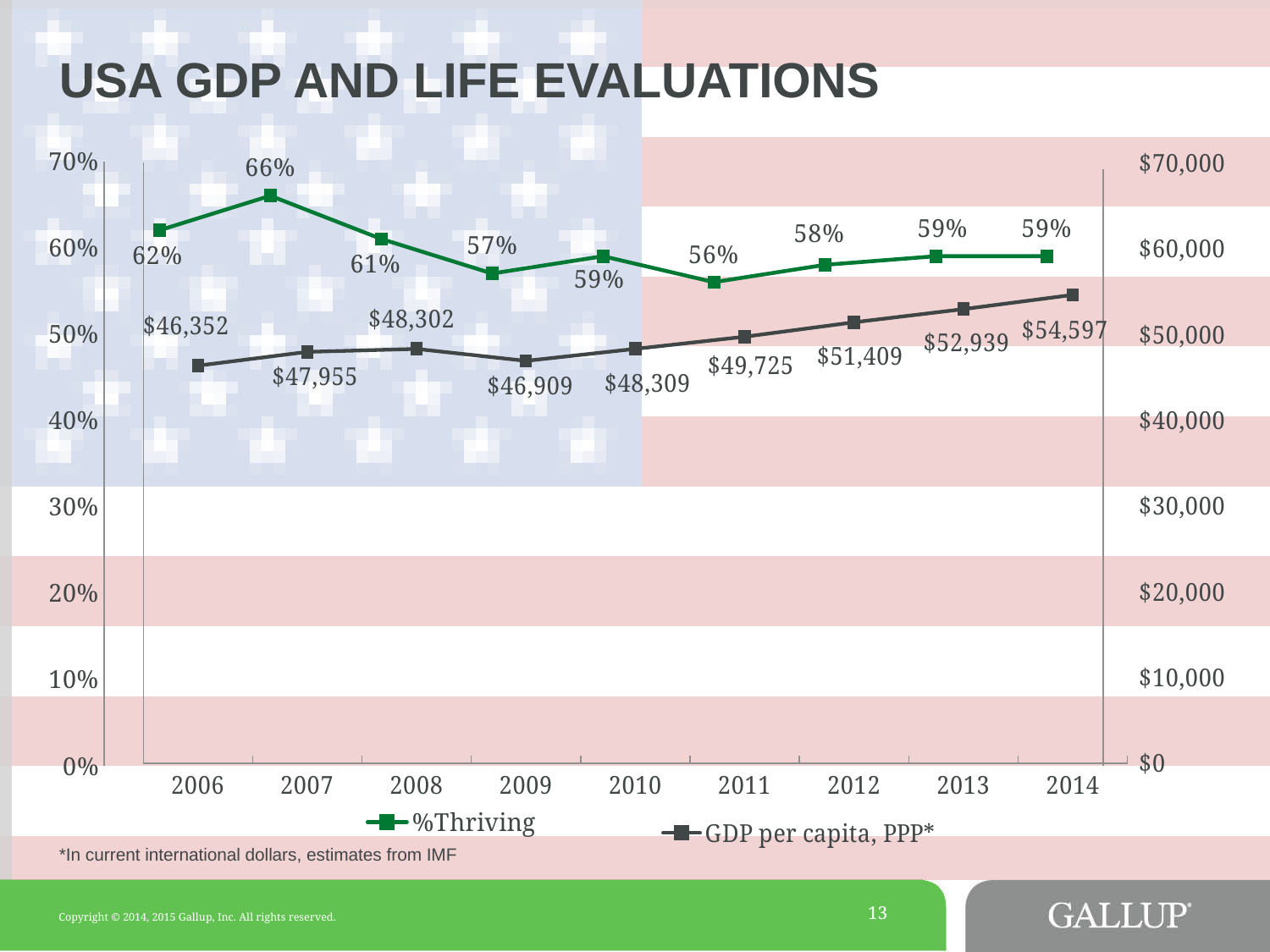
What was GDP per capita, PPP in 2009? $46,909 How many series does the legend list? 2 What kind of chart is shown on the slide? Line chart In which year was %Thriving lowest? 2011 What is the difference in GDP per capita, PPP between 2014 and 2006? $8,245 What was the %Thriving value in 2011? 56% In which year was %Thriving highest? 2007 Which year had a higher %Thriving value, 2008 or 2012? 2008 What was the %Thriving value in 2007? 66% What was GDP per capita, PPP in 2014? $54,597 In which year was GDP per capita, PPP lowest? 2006 How many years are plotted on the x axis? 9